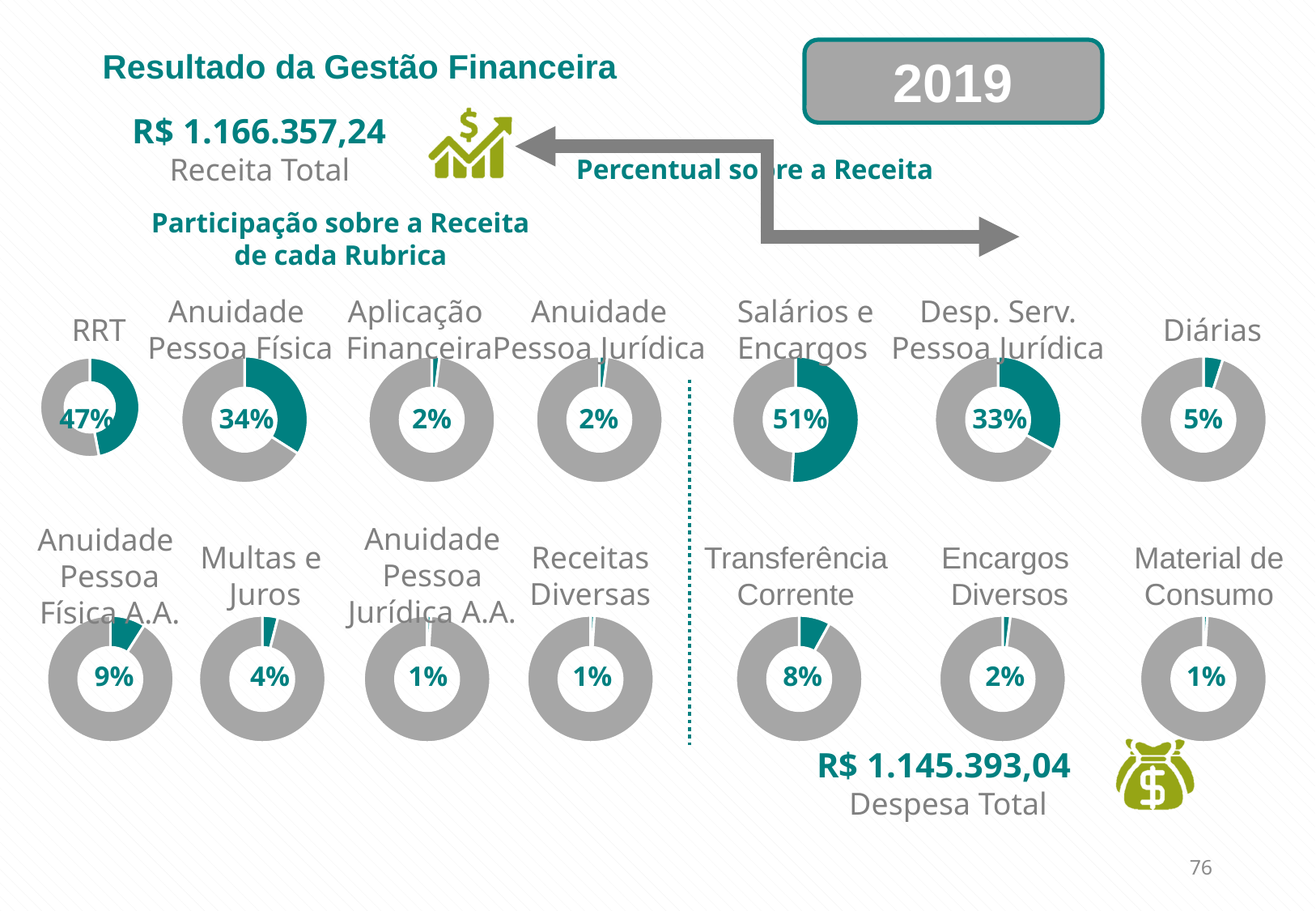
What is the difference in percentage points between the RRT donut chart and the Anuidade Pessoa Física donut chart? 13 percentage points What is the difference in percentage points between the Salários e Encargos donut chart and the Desp. Serv. Pessoa Jurídica donut chart? 18 percentage points In the Transferência Corrente donut chart, what percentage is shown? 8% In the Anuidade Pessoa Física A.A. donut chart, what percentage is shown? 9% In the Desp. Serv. Pessoa Jurídica donut chart, what percentage is shown? 33% In the Salários e Encargos donut chart, what percentage is shown? 51% How many donut charts are shown on the slide in total? 14 Among the donut charts on the right side of the dotted line (despesa), which category has the highest percentage? Salários e Encargos Among the donut charts on the left side of the dotted line (receita), which category has the highest percentage? RRT What kind of chart is used for each of the small charts on the slide? Donut (pie) chart In the RRT donut chart, what percentage is shown? 47% Which shows a larger percentage: the Diárias donut chart or the Multas e Juros donut chart? Diárias